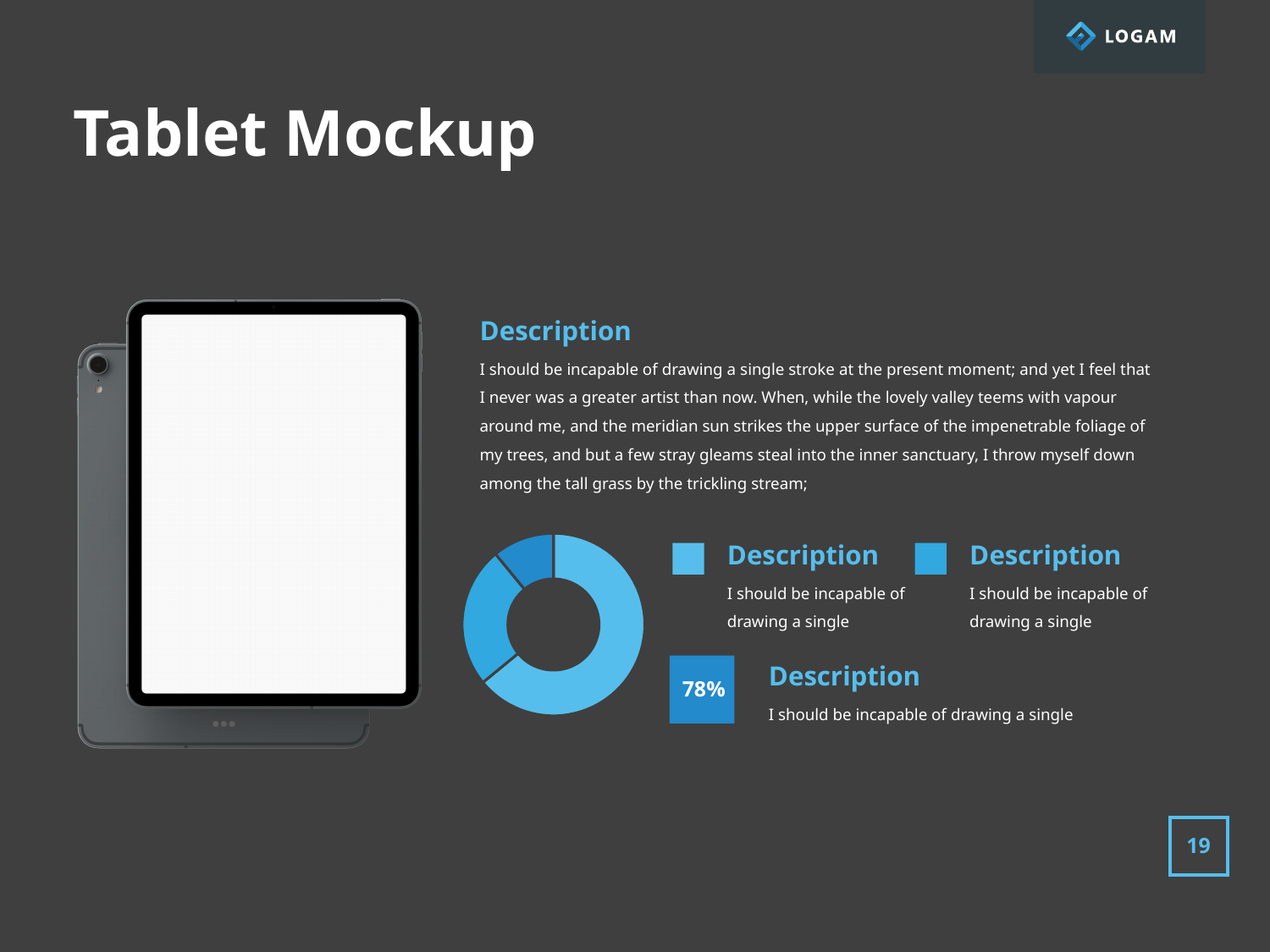
Does the donut chart display data labels on its slices? No Does the donut chart show a legend? No Is the largest slice of the donut chart greater or less than half of the whole? greater Which colour slice takes up the largest share of the donut chart? light blue What kind of chart is shown on the slide? donut chart